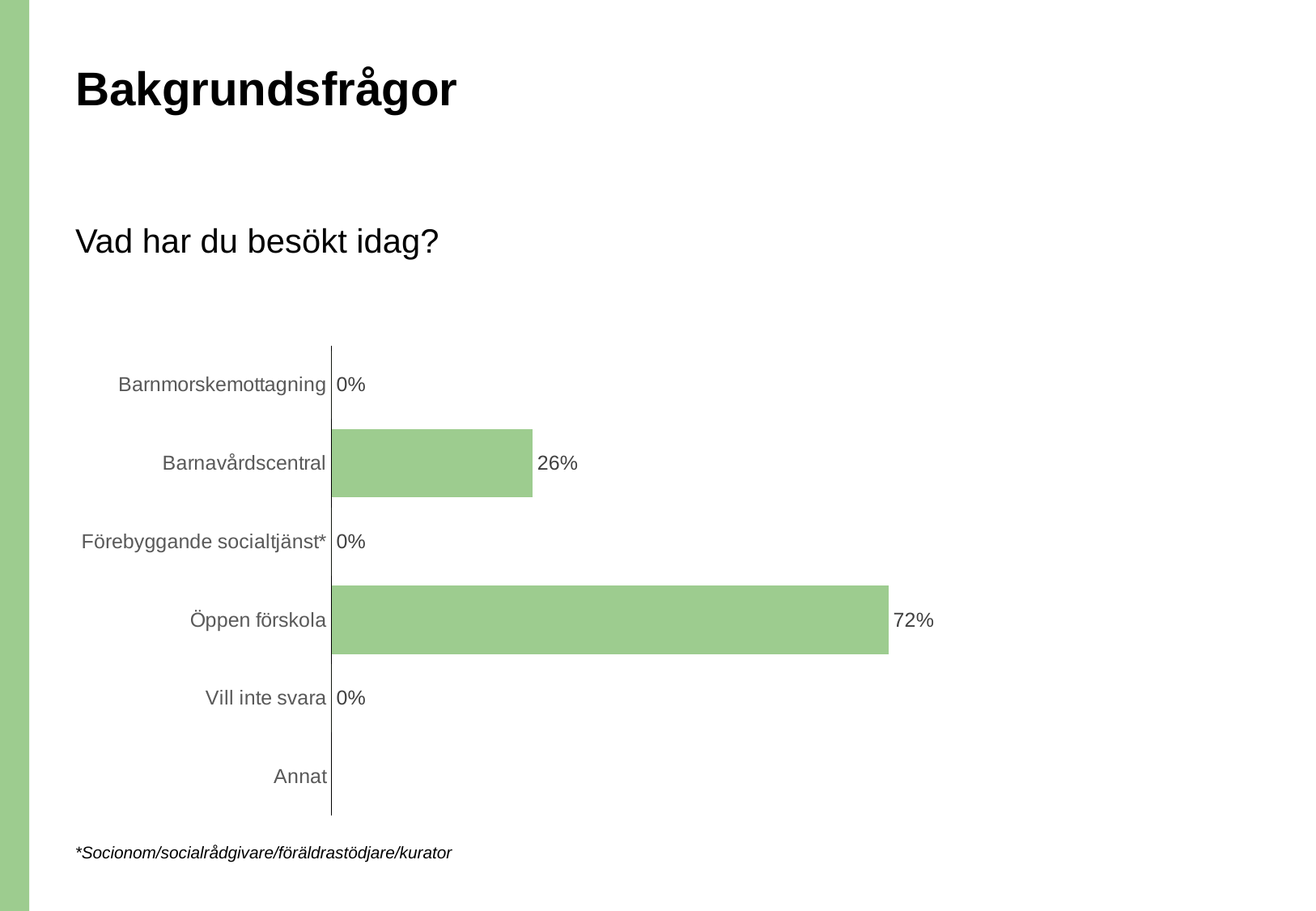
How many categories are shown on the chart? 6 What is the value for Öppen förskola? 72% Which is larger, the value for Barnavårdscentral or the value for Öppen förskola? Öppen förskola What colour are the bars in the chart? Green What kind of chart is shown on the slide? Bar chart What is the value for Vill inte svara? 0% Which category has the highest value? Öppen förskola What question does the chart on the slide answer? Vad har du besökt idag? What is the value for Barnavårdscentral? 26% What is the difference between the values for Öppen förskola and Barnavårdscentral? 46% What is the value for Förebyggande socialtjänst*? 0% What is the value for Barnmorskemottagning? 0%